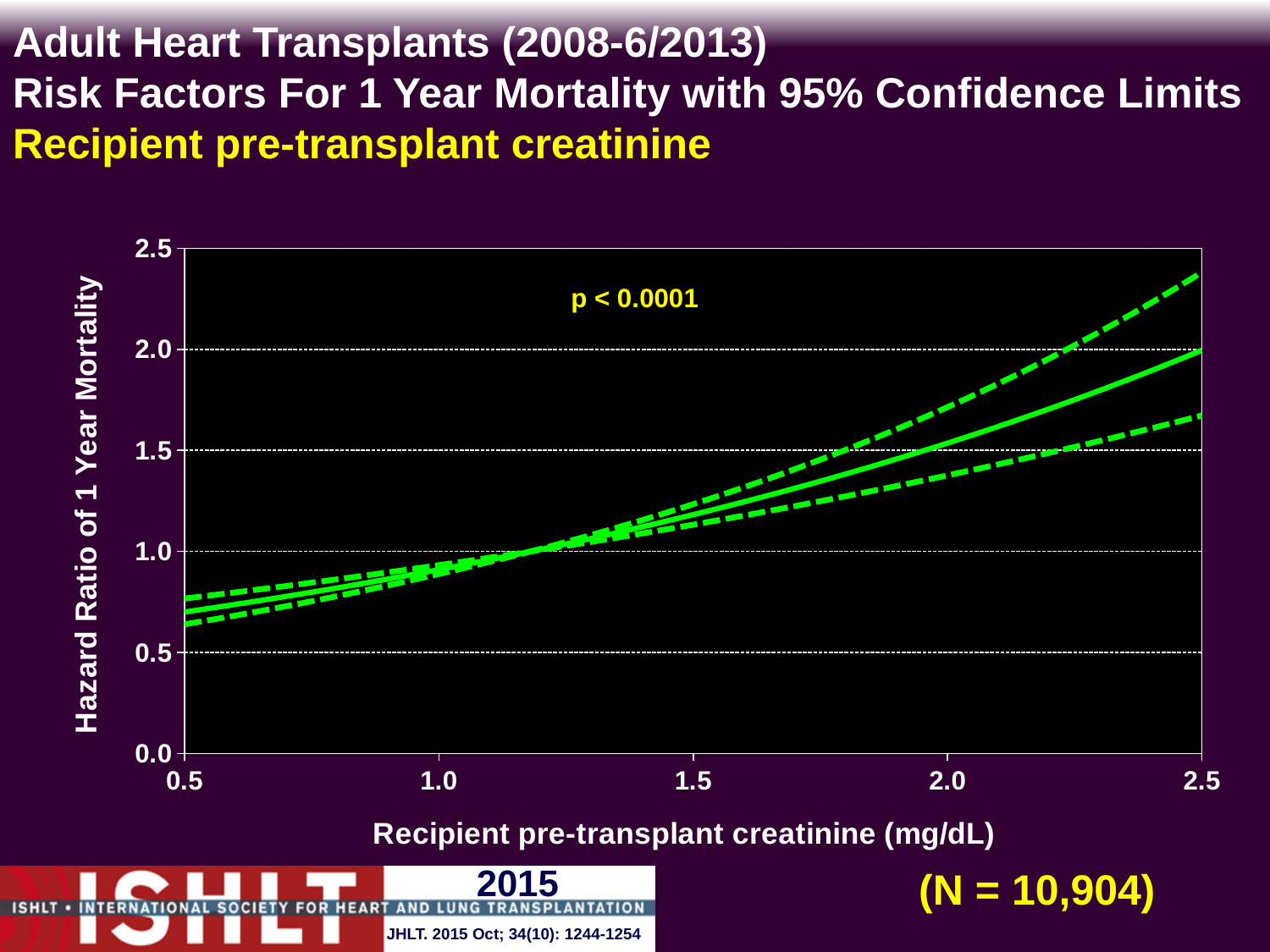
Is the lower dashed confidence limit at a creatinine of 2.0 mg/dL greater or less than 1.5? less Does the hazard ratio of 1 year mortality rise or fall as recipient pre-transplant creatinine increases? rise Is the hazard ratio on the solid line at a creatinine of 1.5 mg/dL greater or less than 1.5? less What is the label of the x axis? Recipient pre-transplant creatinine (mg/dL) Is the hazard ratio on the solid line at a creatinine of 0.5 mg/dL greater or less than 1.0? less What kind of chart is shown on the slide? line chart What p-value is printed on the chart? p < 0.0001 How many lines are plotted on the chart? 3